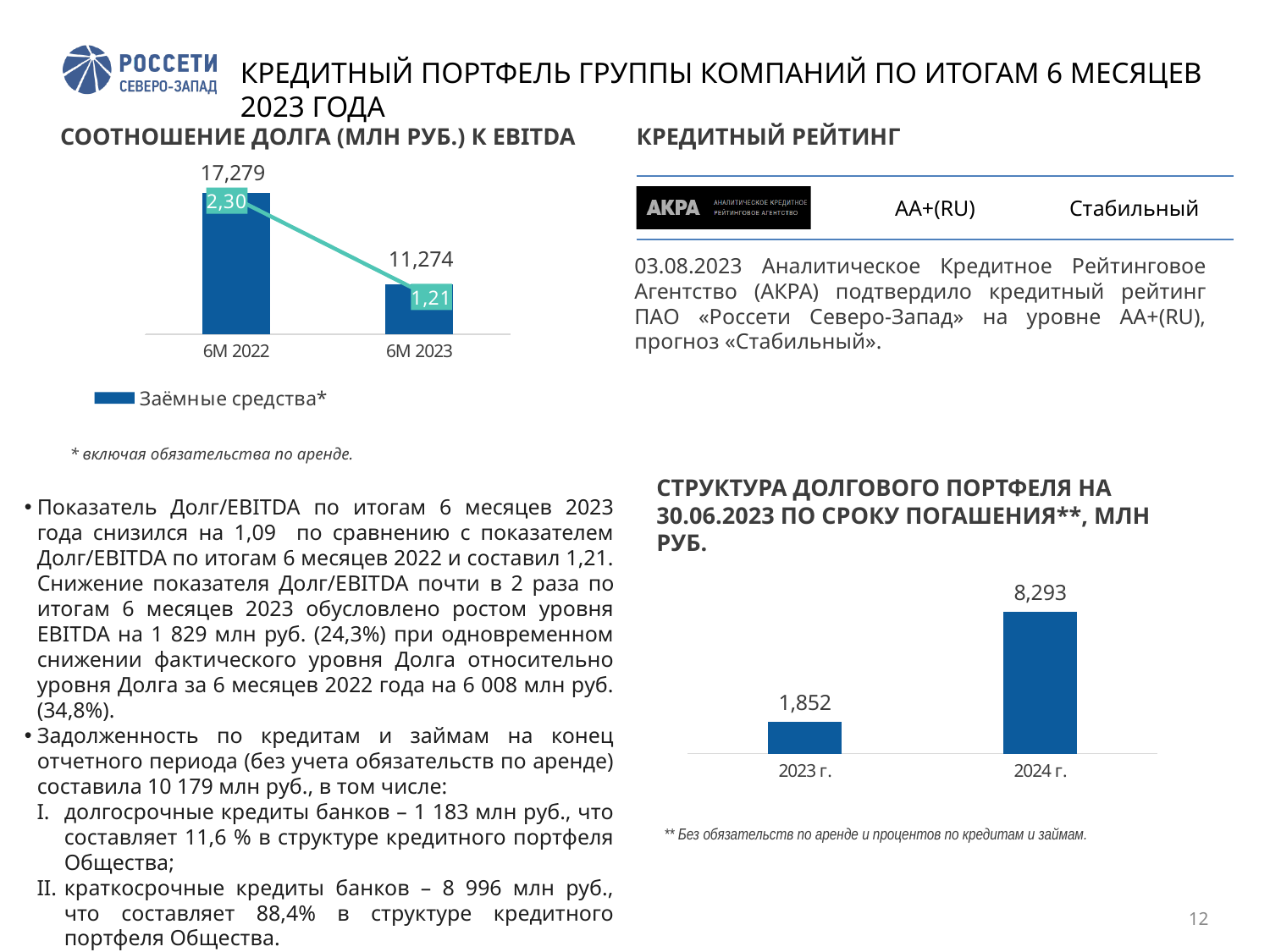
In the chart 'СООТНОШЕНИЕ ДОЛГА (МЛН РУБ.) К EBITDA', what is the legend entry shown below the chart? Заёмные средства* In the chart 'СООТНОШЕНИЕ ДОЛГА (МЛН РУБ.) К EBITDA', by how much did the bar value decrease from 6М 2022 to 6М 2023? 6,005 In the chart 'СООТНОШЕНИЕ ДОЛГА (МЛН РУБ.) К EBITDA', what is the value of the bar for 6М 2023? 11,274 In the chart 'СООТНОШЕНИЕ ДОЛГА (МЛН РУБ.) К EBITDA', what is the value of the bar for 6М 2022? 17,279 In the chart 'СООТНОШЕНИЕ ДОЛГА (МЛН РУБ.) К EBITDA', does the bar value rise or fall from 6М 2022 to 6М 2023? fall What kind of chart is 'СТРУКТУРА ДОЛГОВОГО ПОРТФЕЛЯ НА 30.06.2023 ПО СРОКУ ПОГАШЕНИЯ'? bar chart In the chart 'СООТНОШЕНИЕ ДОЛГА (МЛН РУБ.) К EBITDA', what is the Debt/EBITDA line value shown for 6М 2023? 1,21 In the chart 'СТРУКТУРА ДОЛГОВОГО ПОРТФЕЛЯ НА 30.06.2023 ПО СРОКУ ПОГАШЕНИЯ', what is the difference between the 2024 г. and 2023 г. values? 6,441 In the chart 'СТРУКТУРА ДОЛГОВОГО ПОРТФЕЛЯ НА 30.06.2023 ПО СРОКУ ПОГАШЕНИЯ', which year has the higher value? 2024 г. In the chart 'СТРУКТУРА ДОЛГОВОГО ПОРТФЕЛЯ НА 30.06.2023 ПО СРОКУ ПОГАШЕНИЯ', what is the value for 2024 г.? 8,293 In the chart 'СТРУКТУРА ДОЛГОВОГО ПОРТФЕЛЯ НА 30.06.2023 ПО СРОКУ ПОГАШЕНИЯ', what is the value for 2023 г.? 1,852 In the chart 'СООТНОШЕНИЕ ДОЛГА (МЛН РУБ.) К EBITDA', what is the Debt/EBITDA line value shown for 6М 2022? 2,30